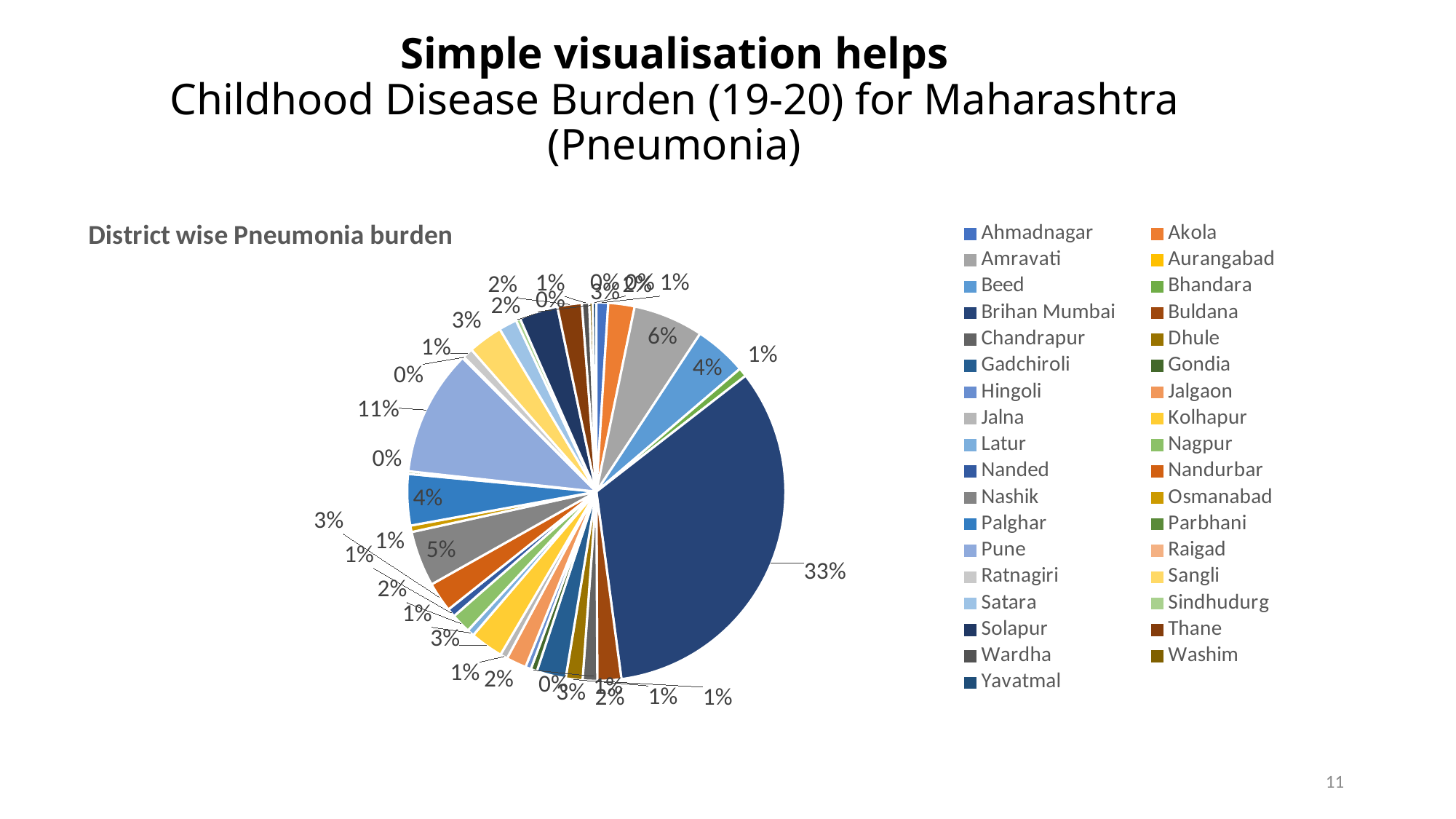
What is the smallest percentage label shown on the pie chart? 0% How many districts are listed in the chart's legend? 35 What is the title of the chart? District wise Pneumonia burden What is the difference in share between Brihan Mumbai and Pune? 22% Which district has the largest slice of the pie chart? Brihan Mumbai Is the share for Brihan Mumbai greater or less than 25%? greater What share of the pneumonia burden does Brihan Mumbai account for? 33% What share of the pneumonia burden does Pune account for? 11% What kind of chart is shown on the slide? pie chart Which has the larger share, Brihan Mumbai or Pune? Brihan Mumbai What is the largest share shown on the pie chart? 33% What share of the pneumonia burden does Amravati account for? 6%